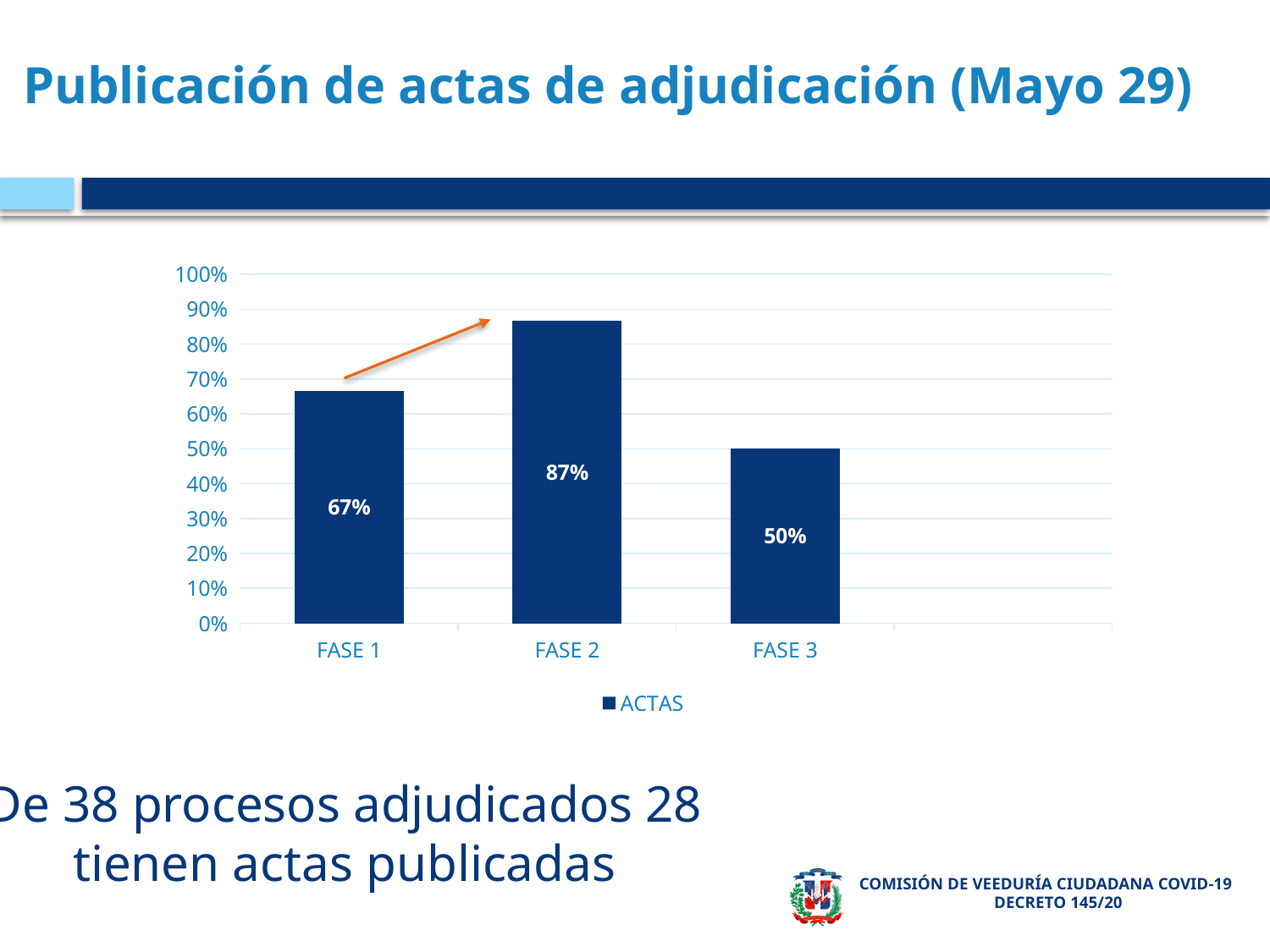
What is the value for FASE 2? 87% What kind of chart is shown on the slide? bar chart What series name does the legend show? ACTAS How many phases are shown on the x axis? 3 Which is larger, the value for FASE 1 or the value for FASE 3? FASE 1 What is the value for FASE 3? 50% What is the difference between the values for FASE 2 and FASE 1? 20% What is the value for FASE 1? 67% What is the difference between the values for FASE 1 and FASE 3? 17% Is the value for FASE 2 greater or less than 80%? greater Which phase has the highest value? FASE 2 Which phase has the lowest value? FASE 3